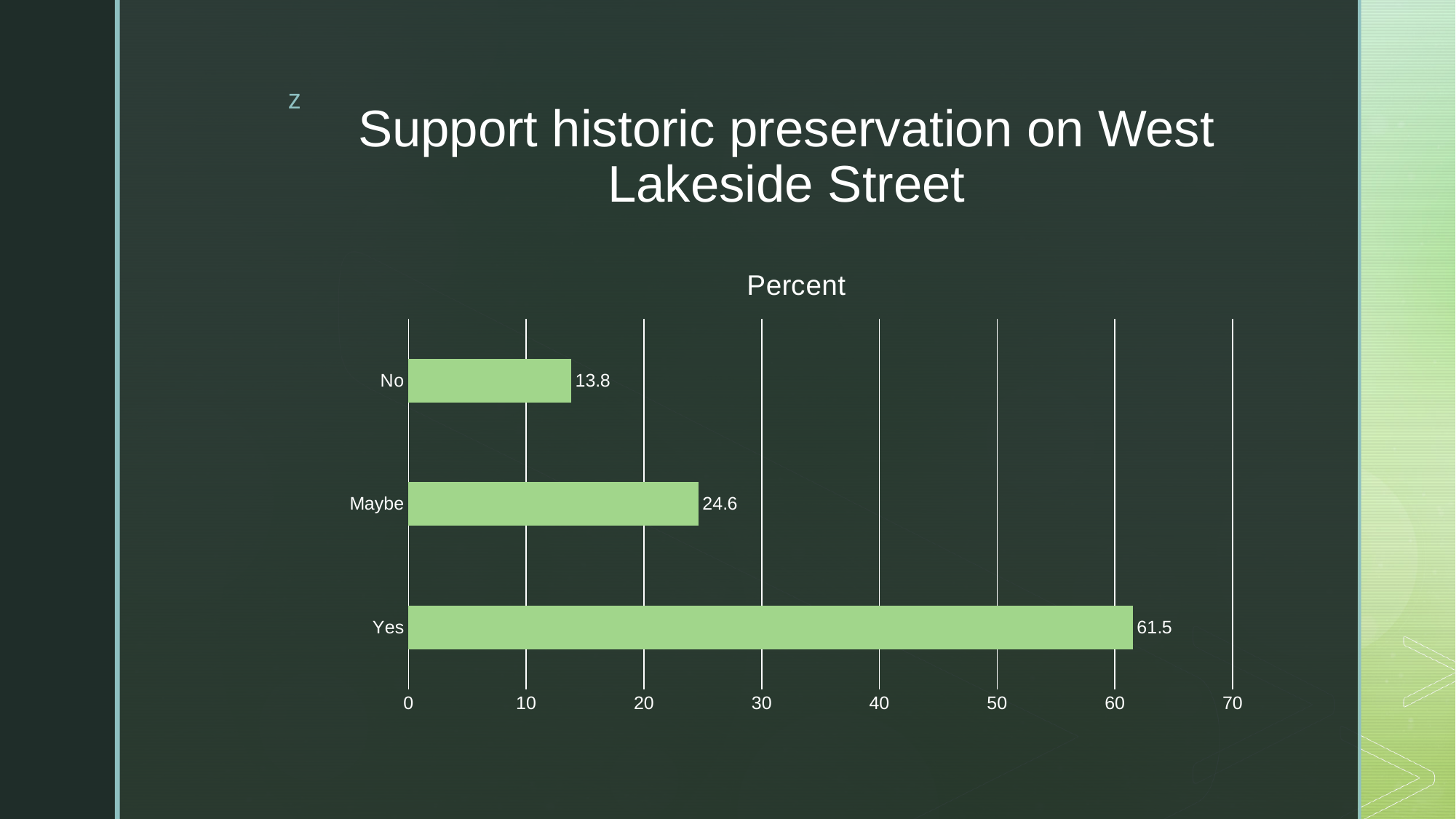
What is the title of the chart? Percent Which category has the highest value? Yes What kind of chart is shown on the slide? bar chart What is the difference between the values for Maybe and No? 10.8 Is the value for Yes greater or less than 60? greater What is the value for No? 13.8 What is the value for Maybe? 24.6 Which is larger, the value for Maybe or the value for No? Maybe What is the value for Yes? 61.5 Which category has the lowest value? No How many categories are shown in the chart? 3 What is the difference between the values for Yes and Maybe? 36.9